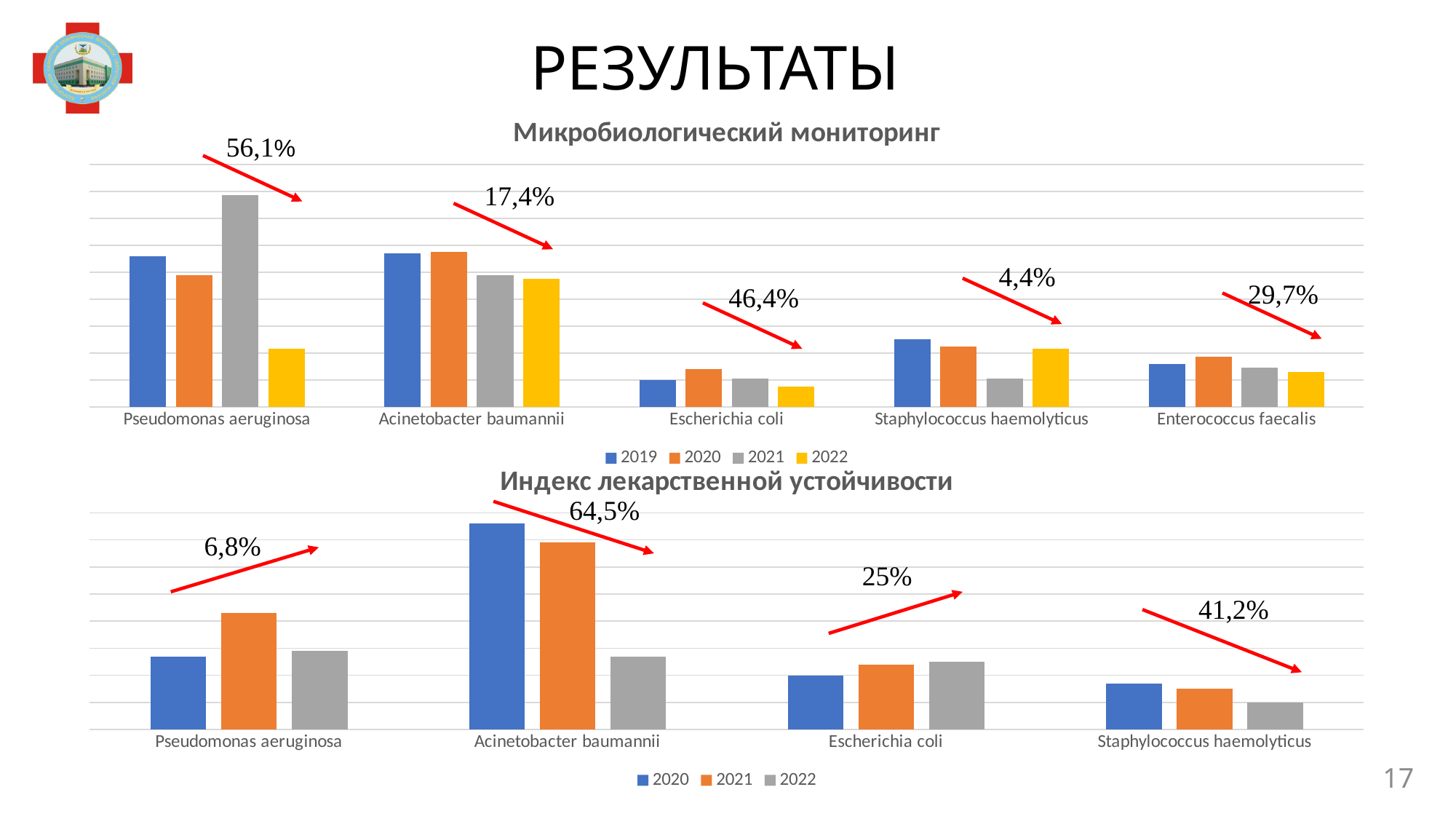
In the top chart "Микробиологический мониторинг", which year has the highest bar for Pseudomonas aeruginosa? 2021 How many categories are shown on the x axis of the top chart "Микробиологический мониторинг"? 5 What kind of chart is the top chart titled "Микробиологический мониторинг"? Bar chart In the bottom chart "Индекс лекарственной устойчивости", which year has the highest bar for Acinetobacter baumannii? 2020 In the top chart "Микробиологический мониторинг", is the 2019 bar for Pseudomonas aeruginosa larger or smaller than the 2022 bar for Pseudomonas aeruginosa? Larger In the top chart "Микробиологический мониторинг", which year has the lowest bar for Staphylococcus haemolyticus? 2021 How many categories are shown on the x axis of the bottom chart "Индекс лекарственной устойчивости"? 4 In the top chart "Микробиологический мониторинг", which year has the highest bar for Escherichia coli? 2020 What is the title of the bottom chart on the slide? Индекс лекарственной устойчивости How many series does the legend of the bottom chart "Индекс лекарственной устойчивости" list? 3 In the bottom chart "Индекс лекарственной устойчивости", do the bars for Escherichia coli rise or fall from 2020 to 2022? Rise How many series does the legend of the top chart "Микробиологический мониторинг" list? 4